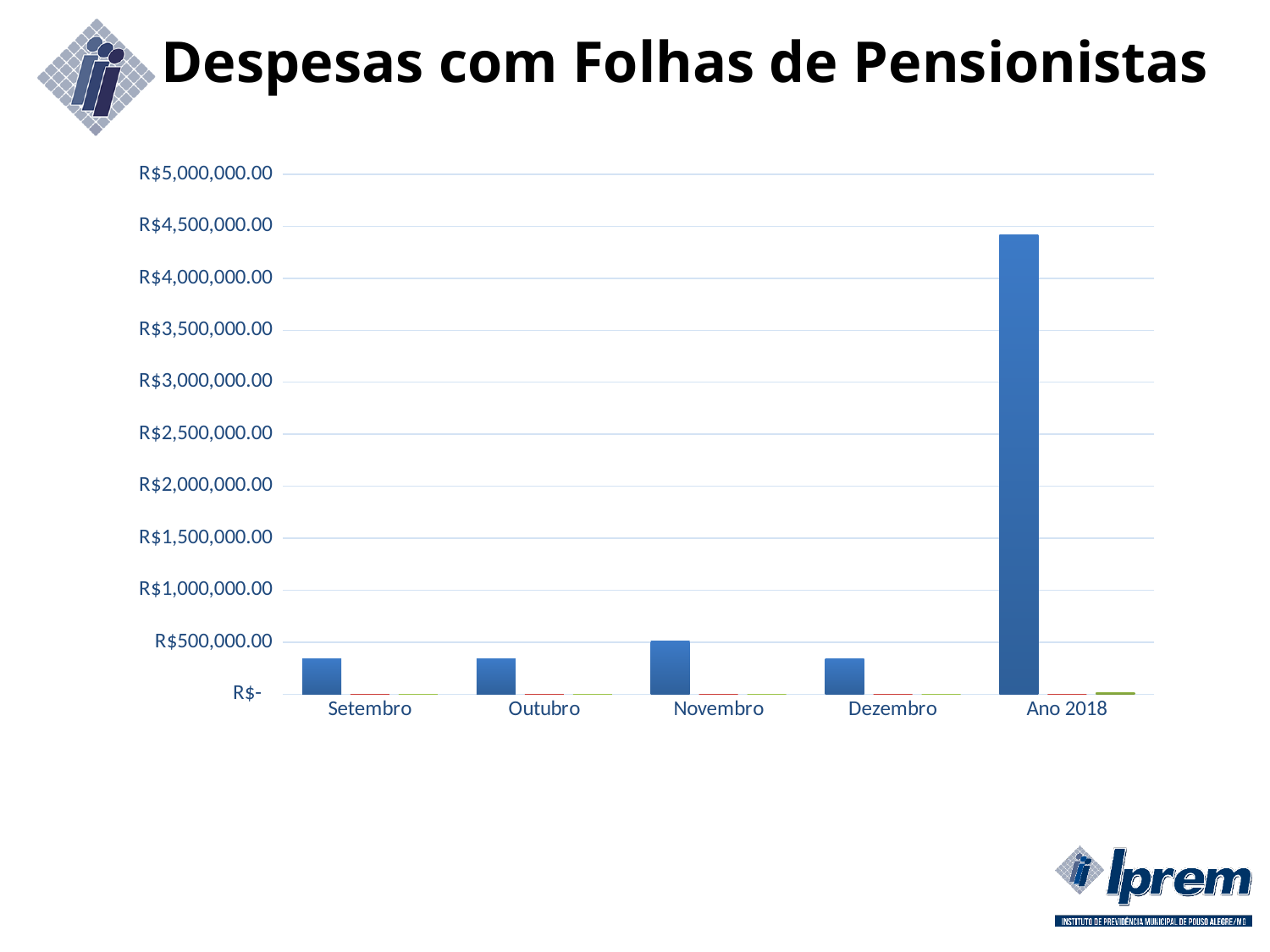
Among the monthly categories (Setembro, Outubro, Novembro, Dezembro), which has the highest blue bar? Novembro Which blue bar is larger, Ano 2018 or Dezembro? Ano 2018 Is the blue bar for Dezembro greater or less than R$1,000,000.00? less Is the blue bar for Novembro greater or less than R$1,000,000.00? less How many categories are shown on the x axis of the chart? 5 What is the title of the slide containing the chart? Despesas com Folhas de Pensionistas Which blue bar is larger, Novembro or Setembro? Novembro Is the blue bar for Ano 2018 greater or less than R$4,500,000.00? less Which category has the highest blue bar in the chart? Ano 2018 What kind of chart is shown on the slide? bar chart